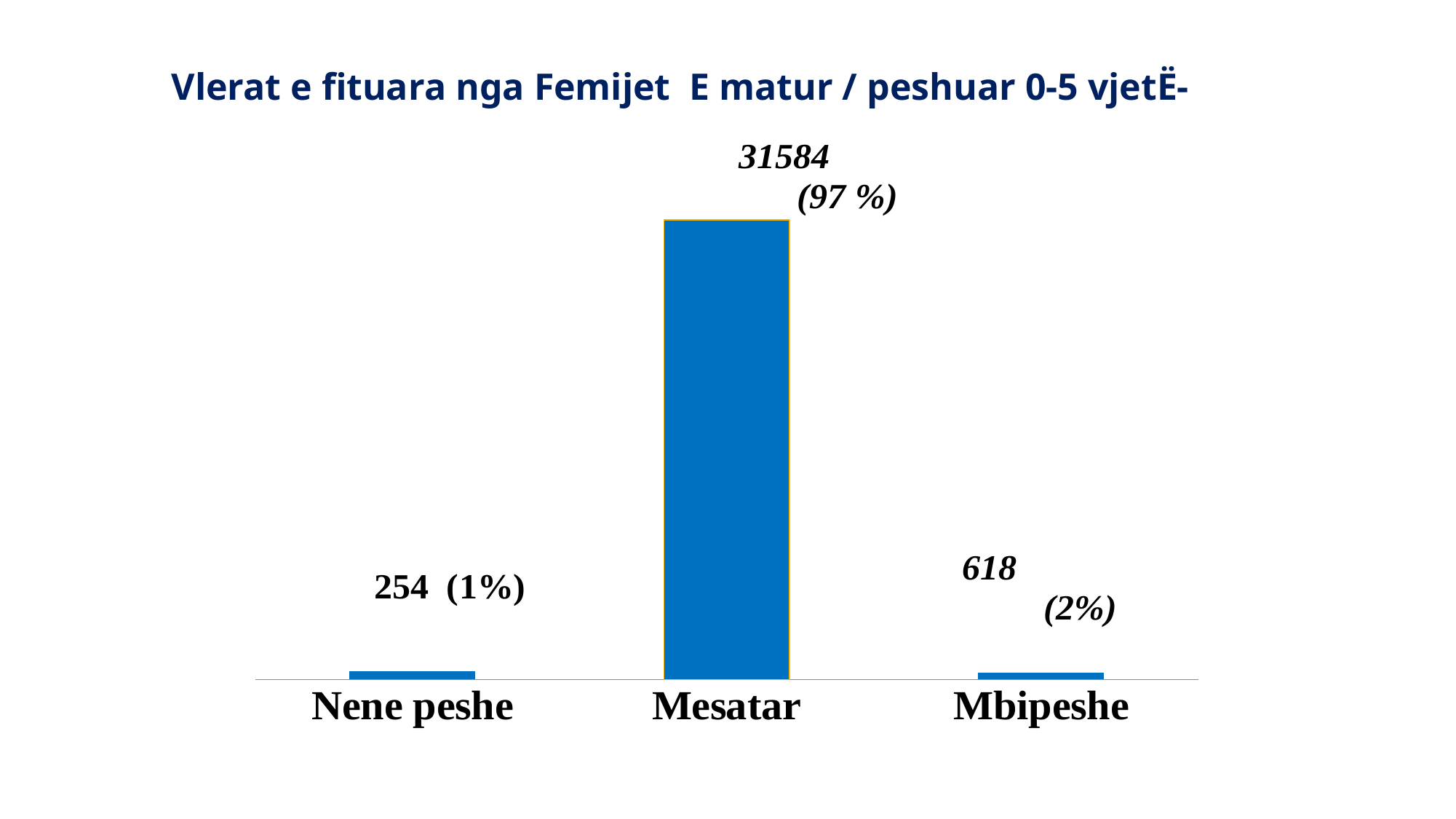
What is the value for Mbipeshe? 618 What percentage is shown for Mesatar? 97 % What kind of chart is shown on the slide? Bar chart What is the difference between the values for Mbipeshe and Nene peshe? 364 What is the value for Mesatar? 31584 Which category has the lowest value? Nene peshe Which category has the highest value? Mesatar What is the difference between the values for Mesatar and Mbipeshe? 30966 What is the value for Nene peshe? 254 Which is larger, the value for Mbipeshe or the value for Nene peshe? Mbipeshe How many categories are shown on the x axis? 3 What percentage is shown for Mbipeshe? 2%